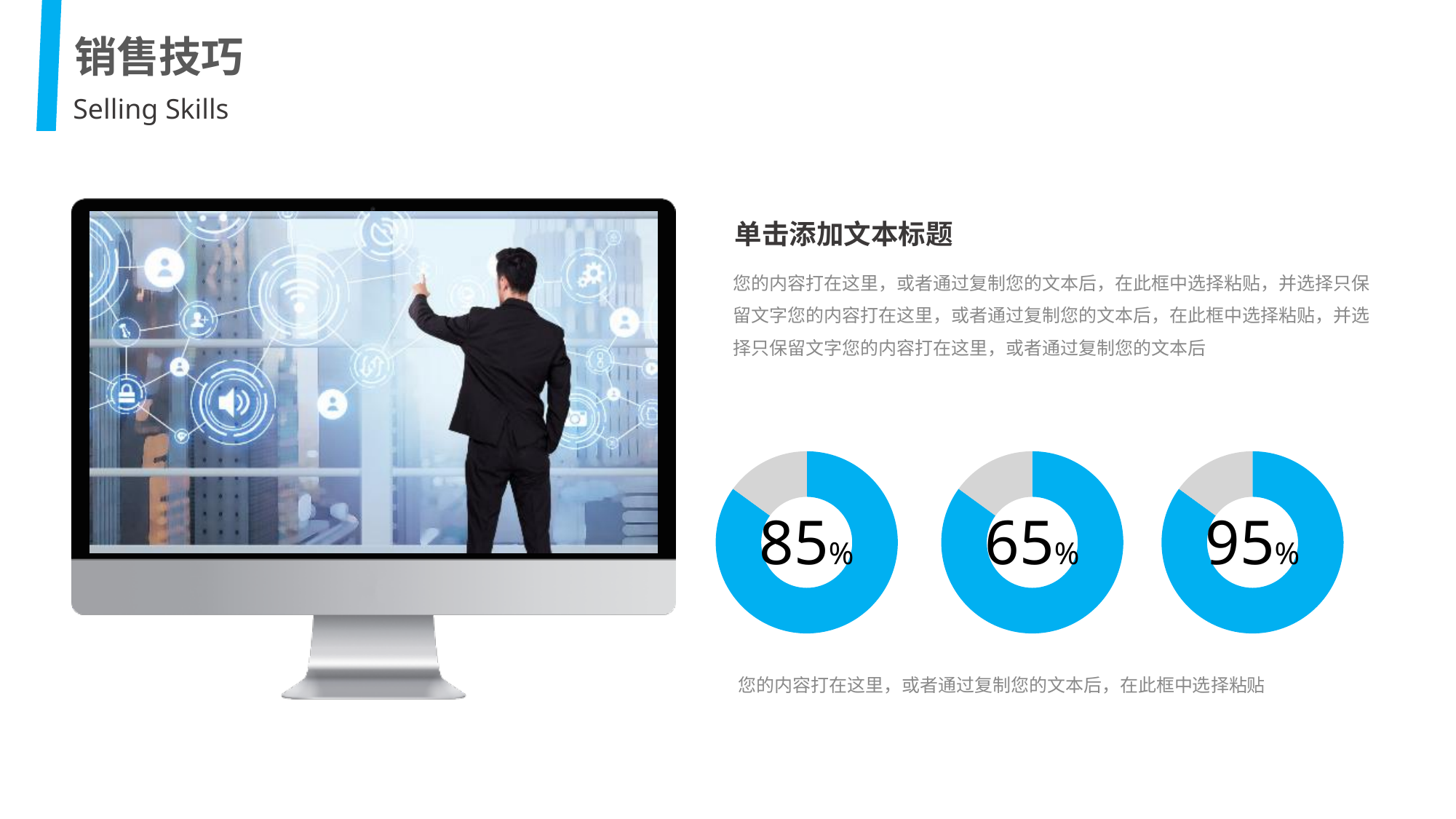
What value is shown in the centre of the right donut chart? 95% How many donut charts are shown on the slide? 3 What colour is used for the filled portion of each donut chart? Blue What is the difference between the percentage in the right donut chart and the percentage in the middle donut chart? 30% Which of the three donut charts shows the highest percentage? The right one (95%) Which of the three donut charts shows the lowest percentage? The middle one (65%) What kind of chart is used to display the three percentages on the slide? Donut chart What value is shown in the centre of the middle donut chart? 65% Which is larger, the percentage in the left donut chart or the percentage in the middle donut chart? The left donut chart (85%) What is the difference between the percentage in the left donut chart and the percentage in the middle donut chart? 20% What value is shown in the centre of the left donut chart? 85%